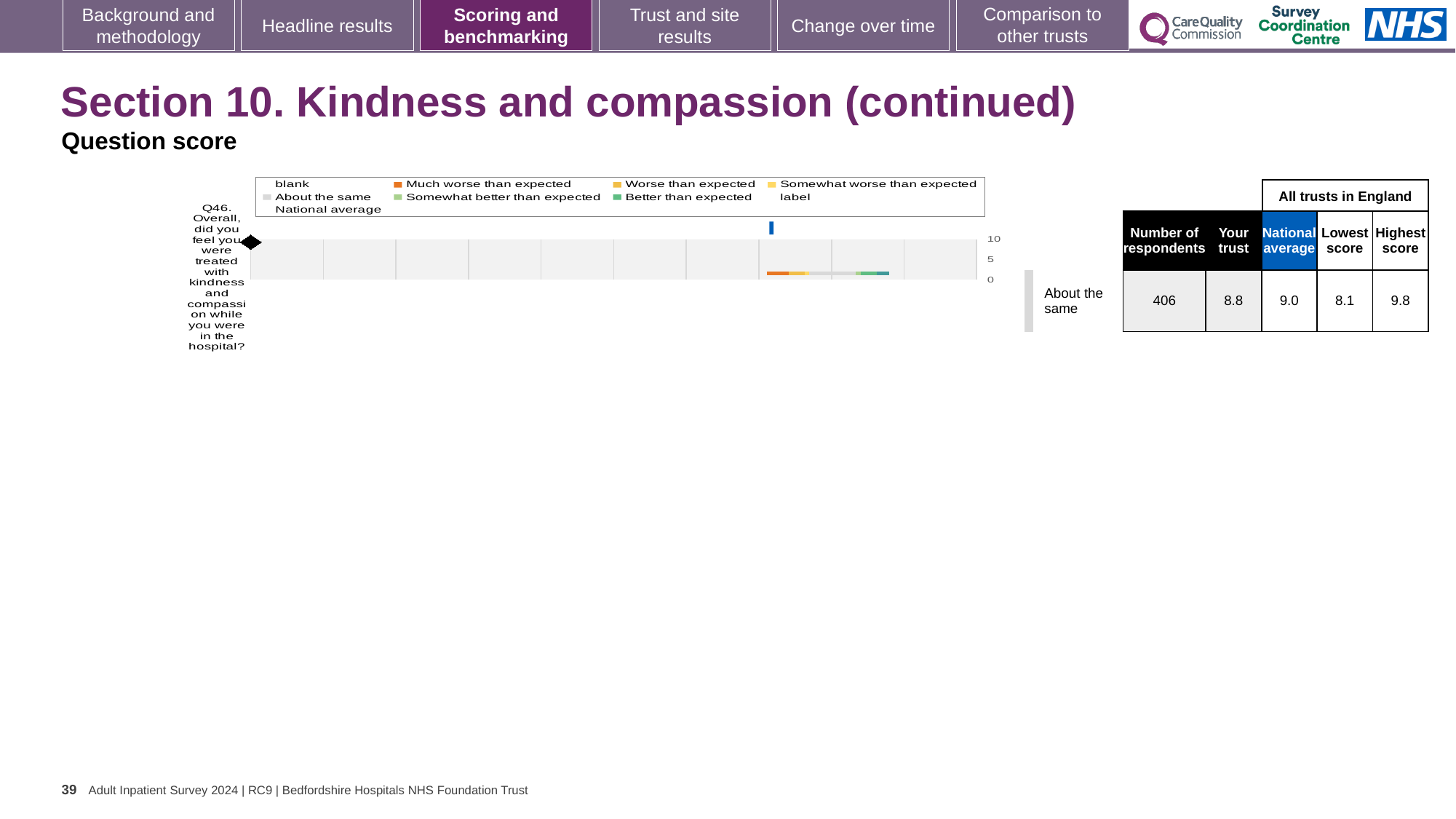
What kind of chart is shown on the slide? bar chart Is the trust's score marker for Q46 on the chart greater or less than 5? greater According to the table next to the chart, how many respondents answered Q46? 406 How many entries does the chart legend list? 9 How many question categories are plotted on the chart? 1 Which question number is plotted on the chart? Q46 What is the highest tick value shown on the chart's score axis? 10 According to the table next to the chart, what is the lowest score among all trusts in England for Q46? 8.1 According to the table next to the chart, what is the highest score among all trusts in England for Q46? 9.8 According to the table next to the chart, what is the national average score for Q46? 9.0 According to the table next to the chart, what is the 'Your trust' score for Q46? 8.8 Which is larger for Q46: the 'Your trust' score or the national average? National average